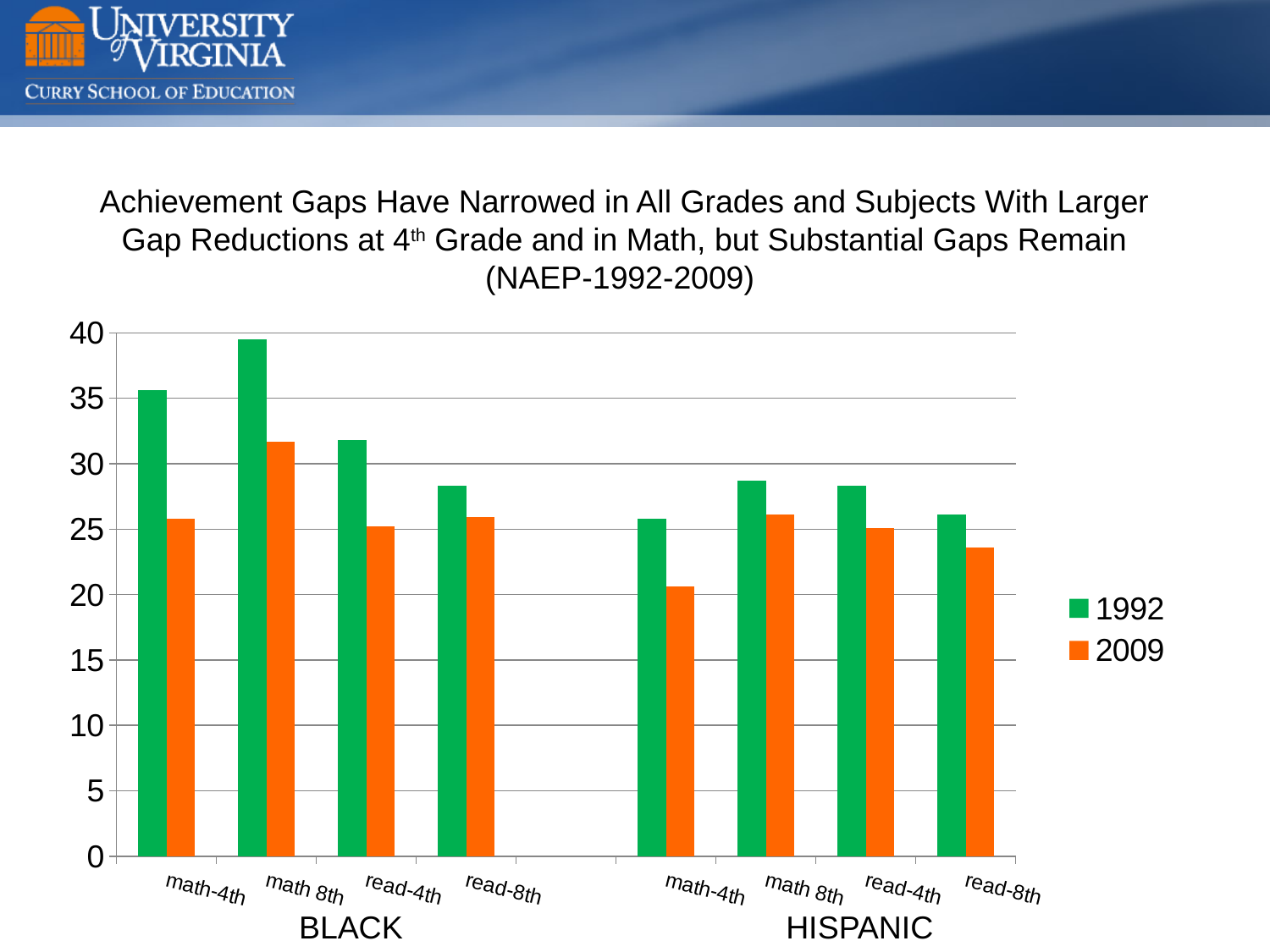
Is the 2009 value for math 8th in the BLACK group greater or less than 30? greater What kind of chart is shown on the slide? Bar chart Which colour represents the 2009 series in the legend? Orange Is the 1992 value for math-4th in the BLACK group greater or less than 30? greater Is the 2009 value for math-4th in the HISPANIC group greater or less than 25? less Which is larger in the BLACK group: the 1992 value for math 8th or the 1992 value for read-4th? math 8th Which category has the highest 1992 bar? math 8th (BLACK) What are the two group labels shown beneath the x axis? BLACK and HISPANIC Which category has the lowest 2009 bar? math-4th (HISPANIC) How many series does the legend list? 2 For math-4th in the BLACK group, which is larger: the 1992 value or the 2009 value? 1992 How many categories are plotted along the x axis? 8